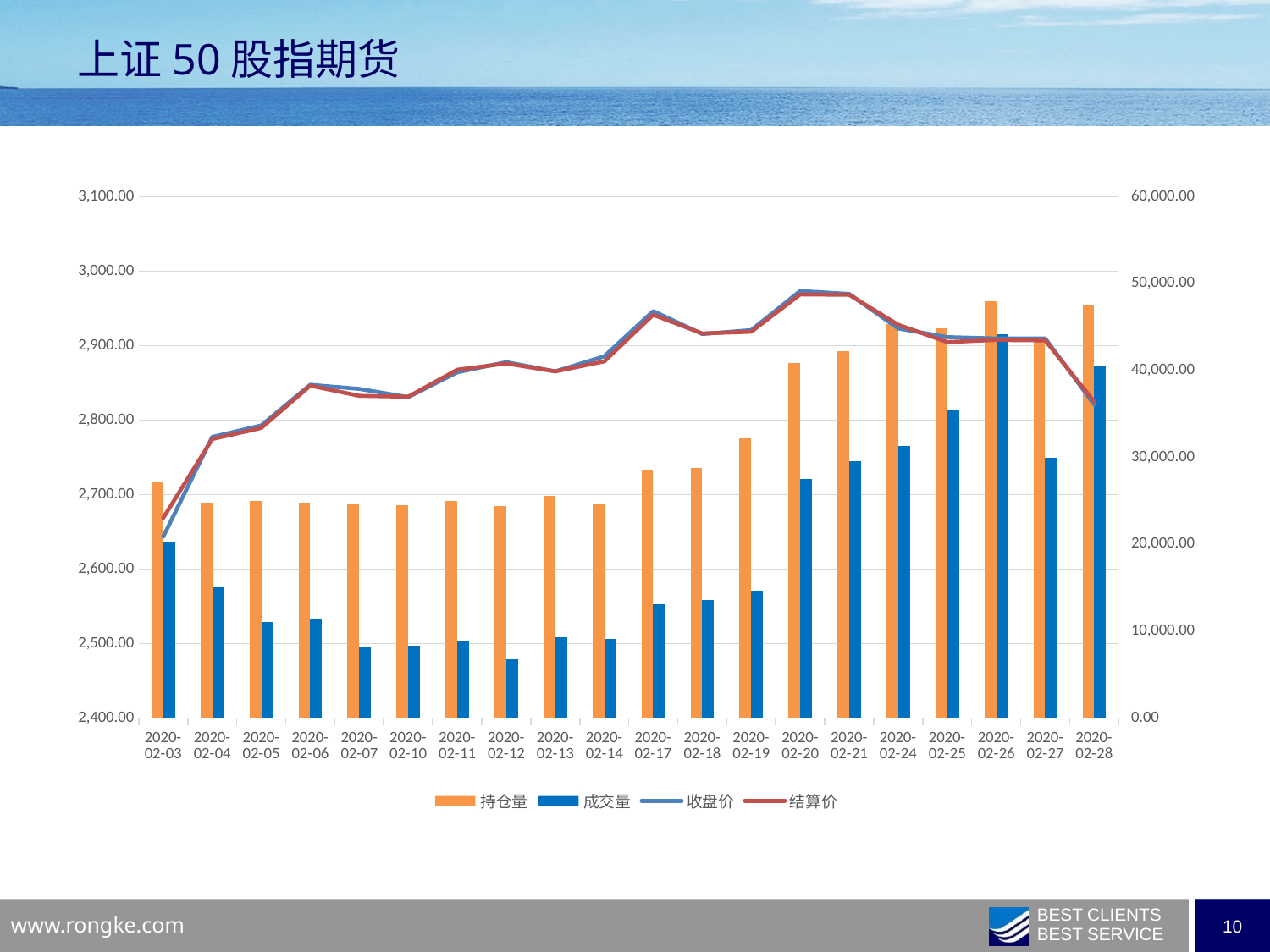
On which date is the 成交量 bar the lowest? 2020-02-12 Does the 收盘价 line rise or fall from 2020-02-03 to 2020-02-20? rise Is the 持仓量 value for 2020-02-03 greater or less than 30,000.00? less How many dates are shown on the x axis? 20 Is the 成交量 value for 2020-02-26 greater or less than 40,000.00? greater On which date does the 收盘价 line reach its highest point? 2020-02-20 On 2020-02-03, which is larger, 持仓量 or 成交量? 持仓量 Is the 收盘价 value for 2020-02-20 greater or less than 2,900.00? greater On which date is the 持仓量 bar the highest? 2020-02-26 How many series does the legend list? 4 What kind of chart is shown on the slide? A combination bar and line chart On which date is the 成交量 bar the highest? 2020-02-26